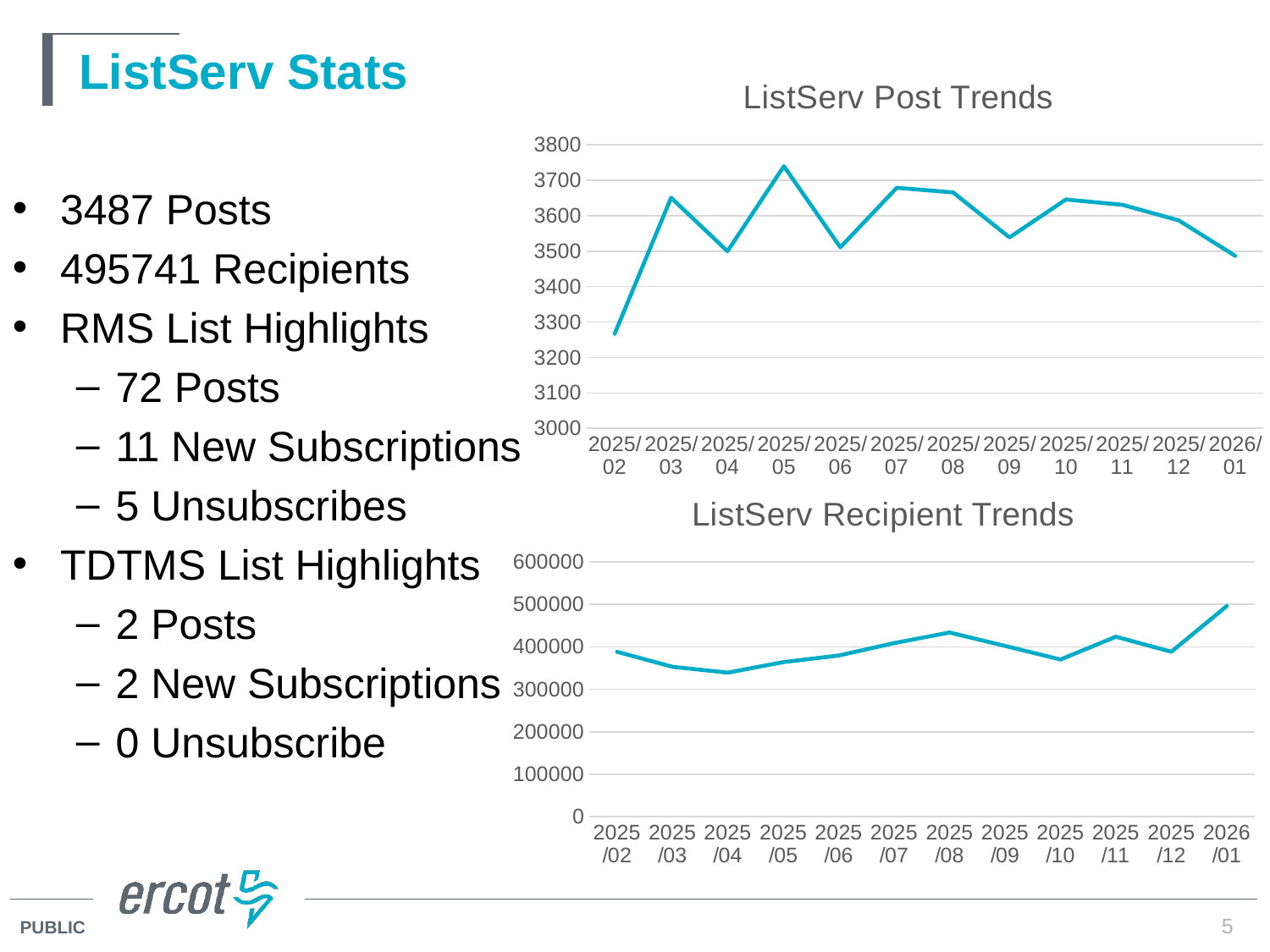
How many data points are plotted on the ListServ Post Trends chart? 12 What is the title of the lower chart on the slide? ListServ Recipient Trends What kind of chart is the ListServ Recipient Trends chart? line chart What kind of chart is the ListServ Post Trends chart? line chart On the ListServ Post Trends chart, which month has the lowest value? 2025/02 On the ListServ Post Trends chart, which is larger, the value for 2025/03 or the value for 2025/04? 2025/03 On the ListServ Post Trends chart, which month has the highest value? 2025/05 On the ListServ Recipient Trends chart, which month has the lowest value? 2025/04 On the ListServ Post Trends chart, is the value for 2025/05 greater or less than 3700? greater On the ListServ Recipient Trends chart, which month has the highest value? 2026/01 On the ListServ Recipient Trends chart, is the value for 2025/08 greater or less than 400000? greater On the ListServ Post Trends chart, is the value for 2025/02 greater or less than 3300? less